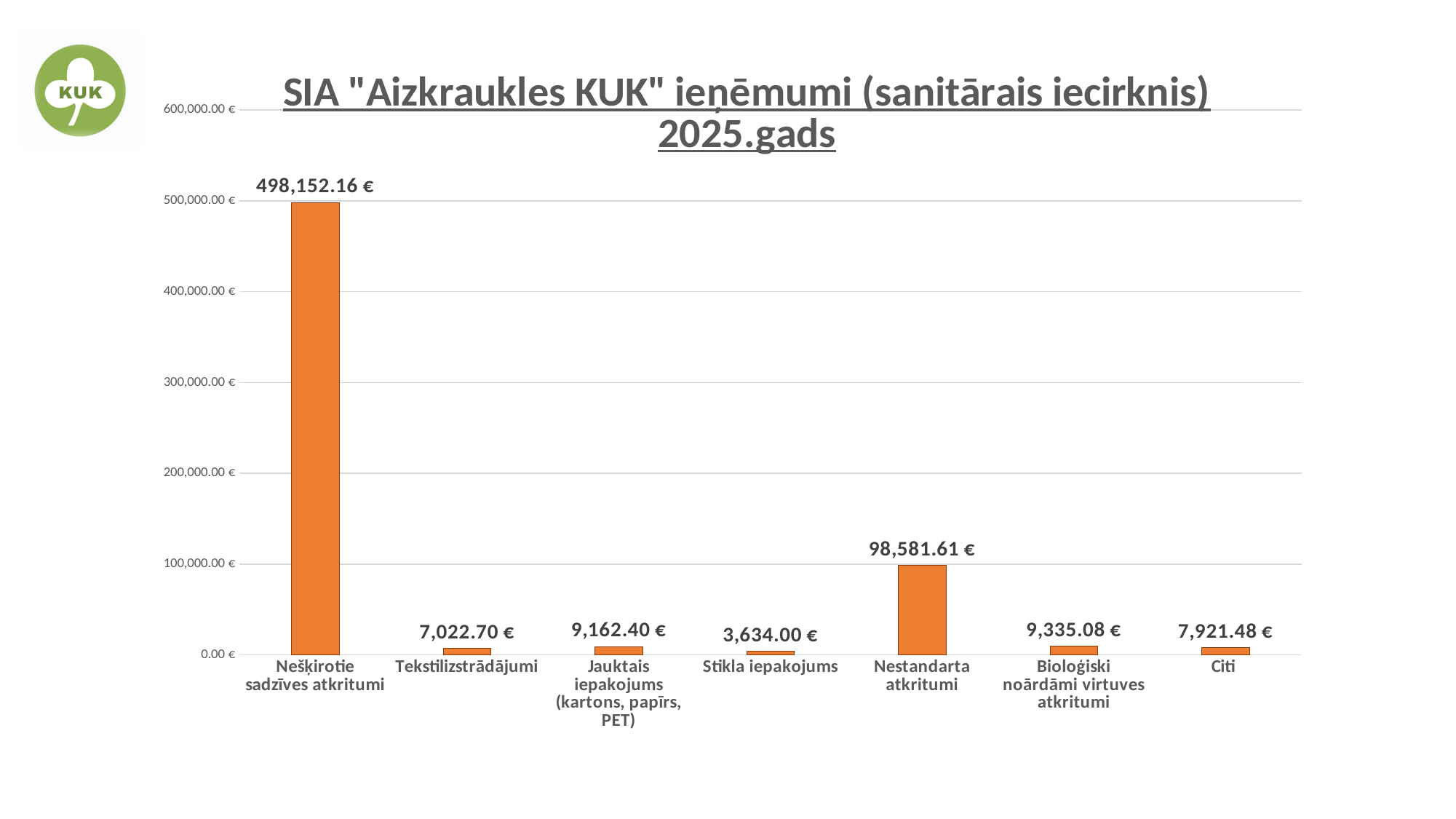
Which category has the highest value? Nešķirotie sadzīves atkritumi How many categories are shown on the x axis? 7 Is the value for Nešķirotie sadzīves atkritumi greater or less than 400,000.00 €? greater What kind of chart is shown on the slide? bar chart What is the difference between the values for Citi and Tekstilizstrādājumi? 898.78 € What is the value for Stikla iepakojums? 3,634.00 € Which category has the lowest value? Stikla iepakojums What is the value for Nešķirotie sadzīves atkritumi? 498,152.16 € Which is larger, the value for Nestandarta atkritumi or the value for Citi? Nestandarta atkritumi What is the value for Bioloģiski noārdāmi virtuves atkritumi? 9,335.08 € What is the value for Nestandarta atkritumi? 98,581.61 € What is the difference between the values for Nešķirotie sadzīves atkritumi and Nestandarta atkritumi? 399,570.55 €